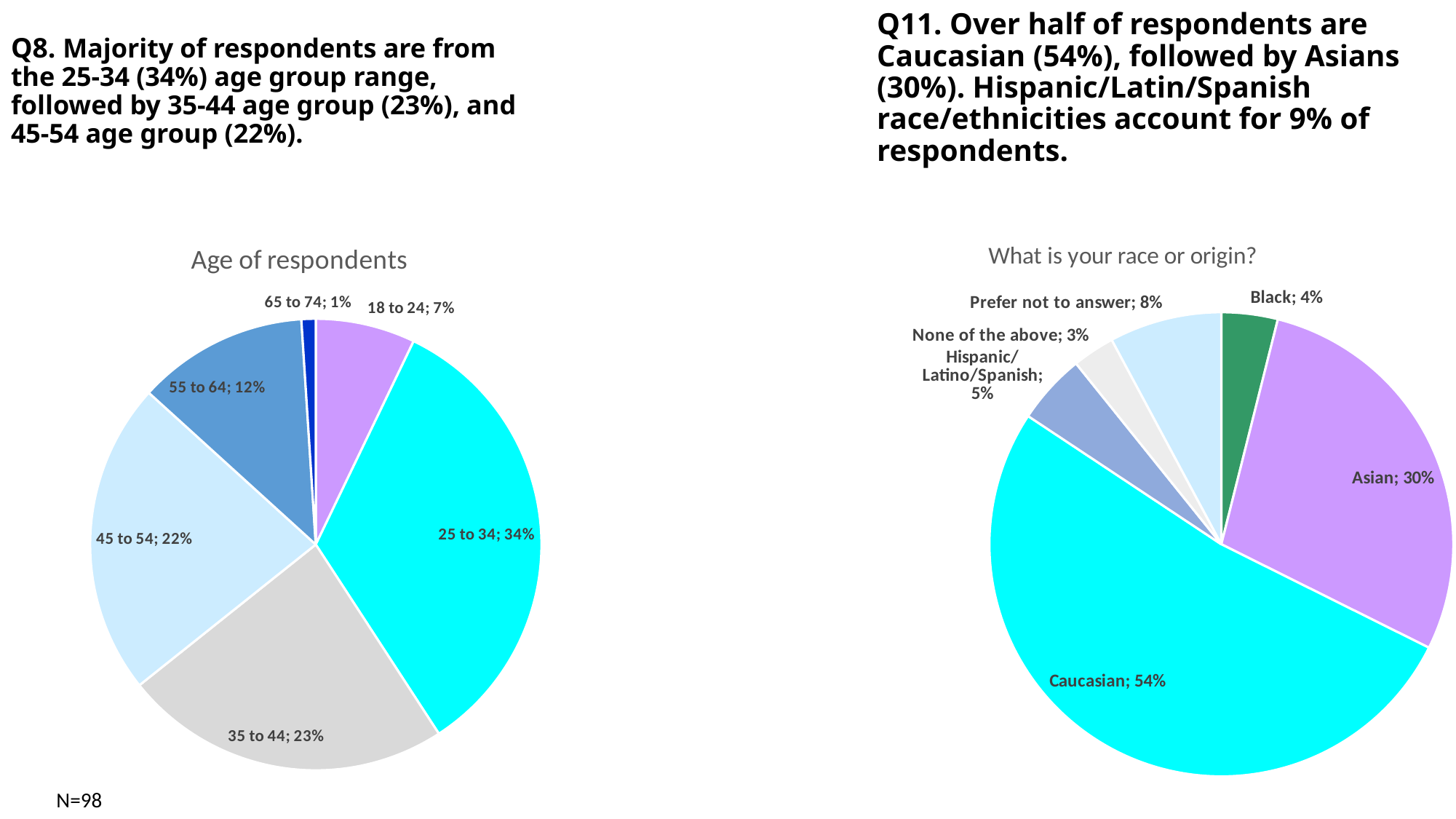
In the 'What is your race or origin?' chart, how many categories are shown? 6 In the 'What is your race or origin?' chart, which is larger, the share for Black or the share for Hispanic/Latino/Spanish? Hispanic/Latino/Spanish In the 'Age of respondents' chart, what share of respondents are in the 55 to 64 age group? 12% In the 'Age of respondents' chart, which age group has the largest share? 25 to 34 What type of chart is used for 'What is your race or origin?'? Pie chart In the 'Age of respondents' chart, what share of respondents are in the 25 to 34 age group? 34% In the 'What is your race or origin?' chart, what share of respondents chose 'Prefer not to answer'? 8% In the 'Age of respondents' chart, how many age groups are shown? 6 In the 'What is your race or origin?' chart, which category has the largest share? Caucasian In the 'Age of respondents' chart, what is the difference in percentage points between the 25 to 34 and 35 to 44 groups? 11 In the 'What is your race or origin?' chart, what share of respondents are Asian? 30% In the 'Age of respondents' chart, which age group has the smallest share? 65 to 74